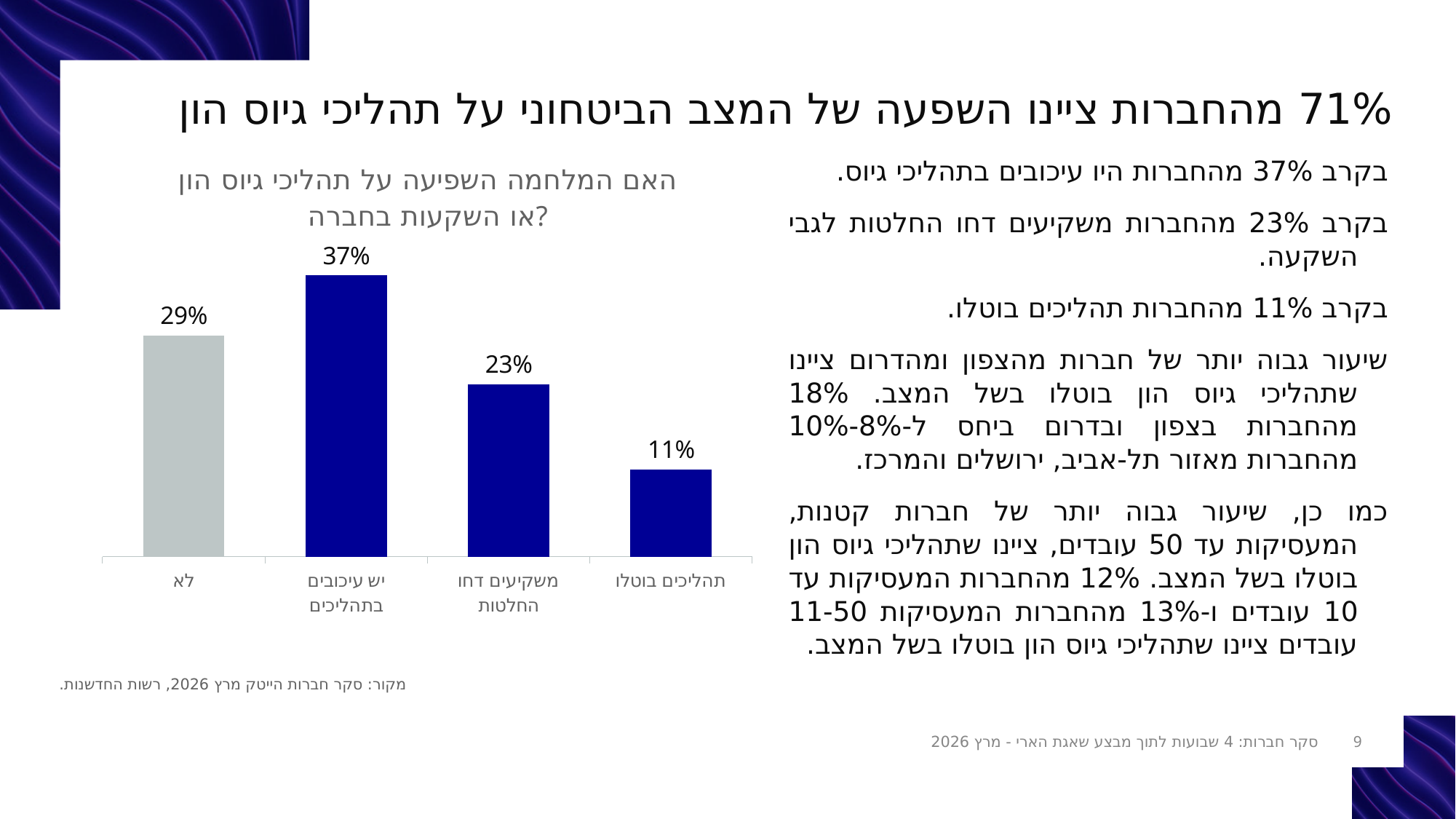
What is the difference between the values for "יש עיכובים בתהליכים" and "תהליכים בוטלו"? 26% Which category has the lowest value in the chart? תהליכים בוטלו What value does the chart show for "תהליכים בוטלו"? 11% What value does the chart show for "לא"? 29% Which category has the highest value in the chart? יש עיכובים בתהליכים What kind of chart is shown on the slide? Bar chart How many categories are shown in the chart? 4 What value does the chart show for "יש עיכובים בתהליכים"? 37% What value does the chart show for "משקיעים דחו החלטות"? 23% What is the title of the chart? האם המלחמה השפיעה על תהליכי גיוס הון או השקעות בחברה? What is the difference between the values for "לא" and "משקיעים דחו החלטות"? 6% Which is larger: the value for "לא" or the value for "משקיעים דחו החלטות"? לא